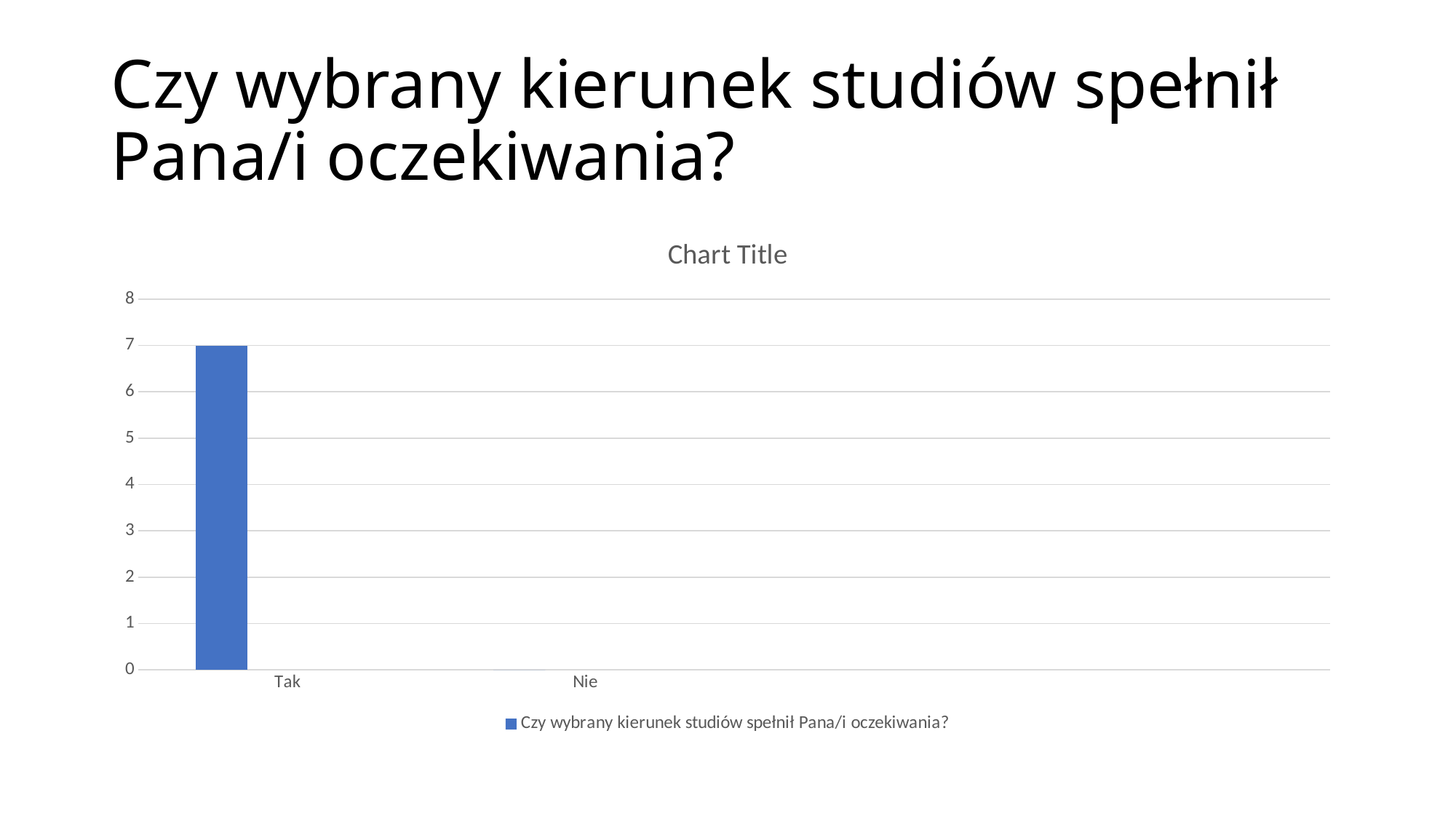
What kind of chart is shown on the slide? bar chart Which is larger, the value for Tak or the value for Nie? Tak What is the value for Tak? 7 Is the value for Tak greater or less than 5? greater What is the value for Nie? 0 What is the difference between the value for Tak and the value for Nie? 7 What is the legend entry of the chart? Czy wybrany kierunek studiów spełnił Pana/i oczekiwania? How many series does the chart legend list? 1 Which category has the highest value? Tak How many categories are shown on the x axis of the chart? 2 What is the title shown above the chart? Chart Title Which category has the lowest value? Nie